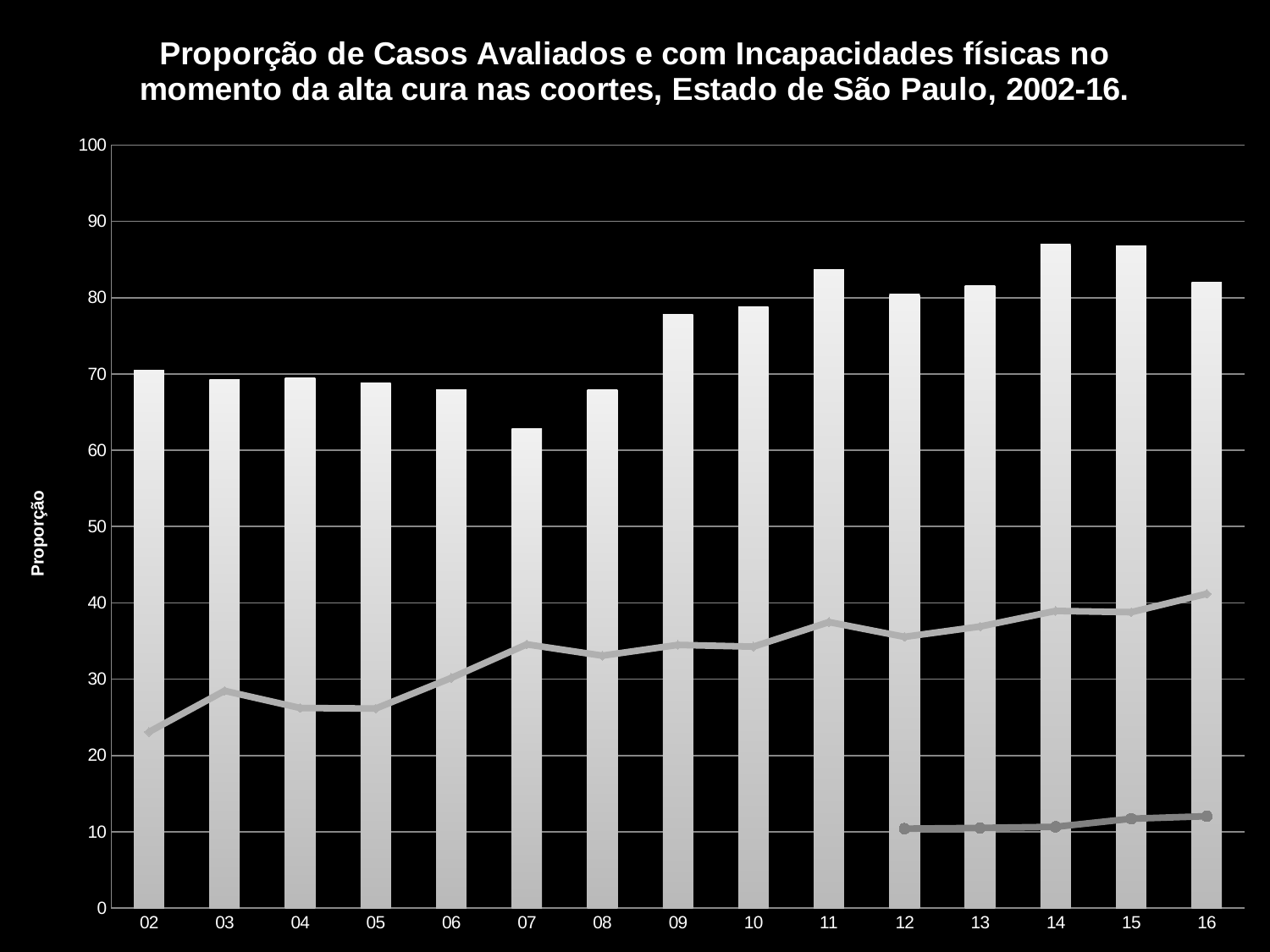
Which bar is taller, 11 or 02? 11 Is the bar for 14 greater or less than 80? greater Is the bar for 09 greater or less than 70? greater Is the bar for 07 greater or less than 70? less Which year has the lowest bar? 07 What is the label of the vertical axis? Proporção Does the upper line series generally rise or fall from 02 to 16? rise Which bar is taller, 06 or 13? 13 How many years (categories) are shown along the x axis? 15 What kind of chart is shown on the slide? A bar chart combined with line series